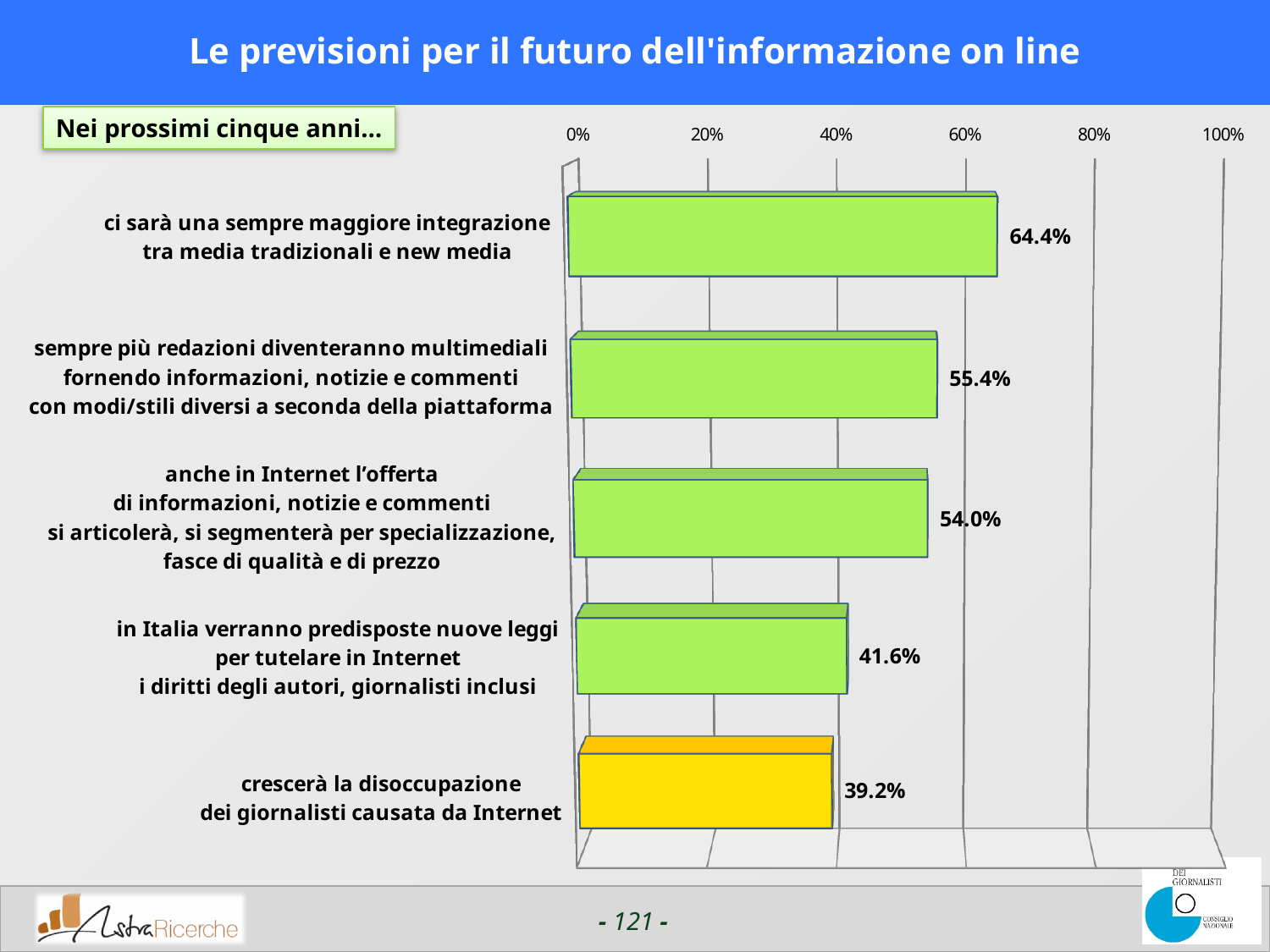
What is the difference in percentage points between the highest value (64.4%) and the lowest value (39.2%)? 25.2 Which prediction has the lowest percentage? crescerà la disoccupazione dei giornalisti causata da Internet What percentage is shown for "ci sarà una sempre maggiore integrazione tra media tradizionali e new media"? 64.4% Which bar is coloured differently (yellow) from the others? crescerà la disoccupazione dei giornalisti causata da Internet What value is shown for "crescerà la disoccupazione dei giornalisti causata da Internet"? 39.2% Is the value for "crescerà la disoccupazione dei giornalisti causata da Internet" greater or less than 40%? less What percentage is shown for "in Italia verranno predisposte nuove leggi per tutelare in Internet i diritti degli autori, giornalisti inclusi"? 41.6% What type of chart is shown on the slide? bar chart What is the difference between the value for "sempre più redazioni diventeranno multimediali..." (55.4%) and "anche in Internet l'offerta di informazioni..." (54.0%)? 1.4 Which prediction has the highest percentage? ci sarà una sempre maggiore integrazione tra media tradizionali e new media Which is larger: the value for "sempre più redazioni diventeranno multimediali..." or the value for "anche in Internet l'offerta di informazioni..."? sempre più redazioni diventeranno multimediali... How many predictions (bars) are shown in the chart? 5